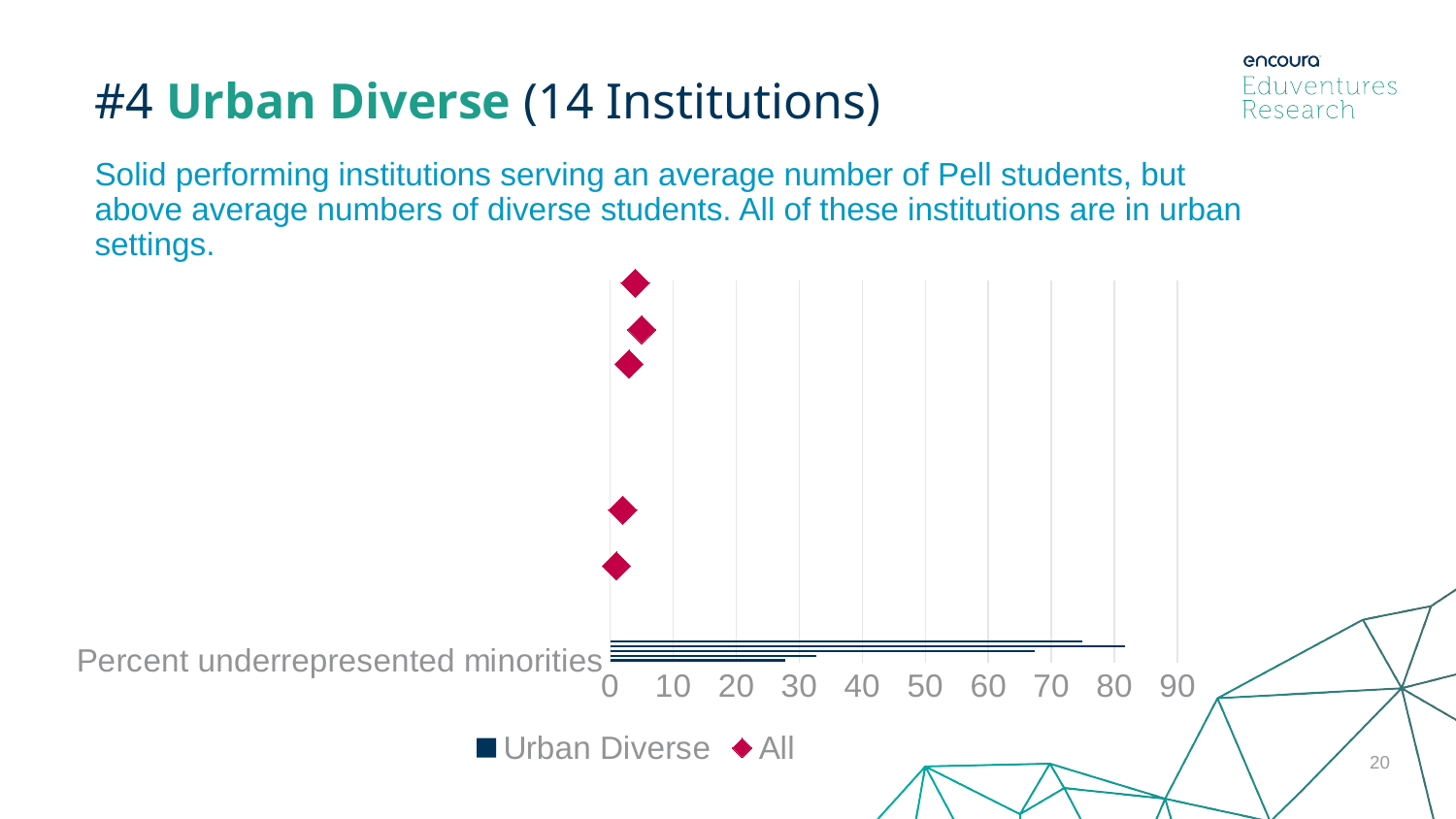
What is the category label shown on the chart's vertical axis? Percent underrepresented minorities Is the longest Urban Diverse bar greater or less than 70? greater Which series is shown with diamond markers in the chart? All Is the longest Urban Diverse bar greater or less than 90? less How many series does the chart legend list? 2 Which series reaches higher values on the horizontal axis, Urban Diverse or All? Urban Diverse Is the shortest Urban Diverse bar greater or less than 40? less How many diamond markers for the All series are plotted on the chart? 5 What is the highest tick value shown on the chart's horizontal axis? 90 What are the two series named in the chart legend? Urban Diverse and All